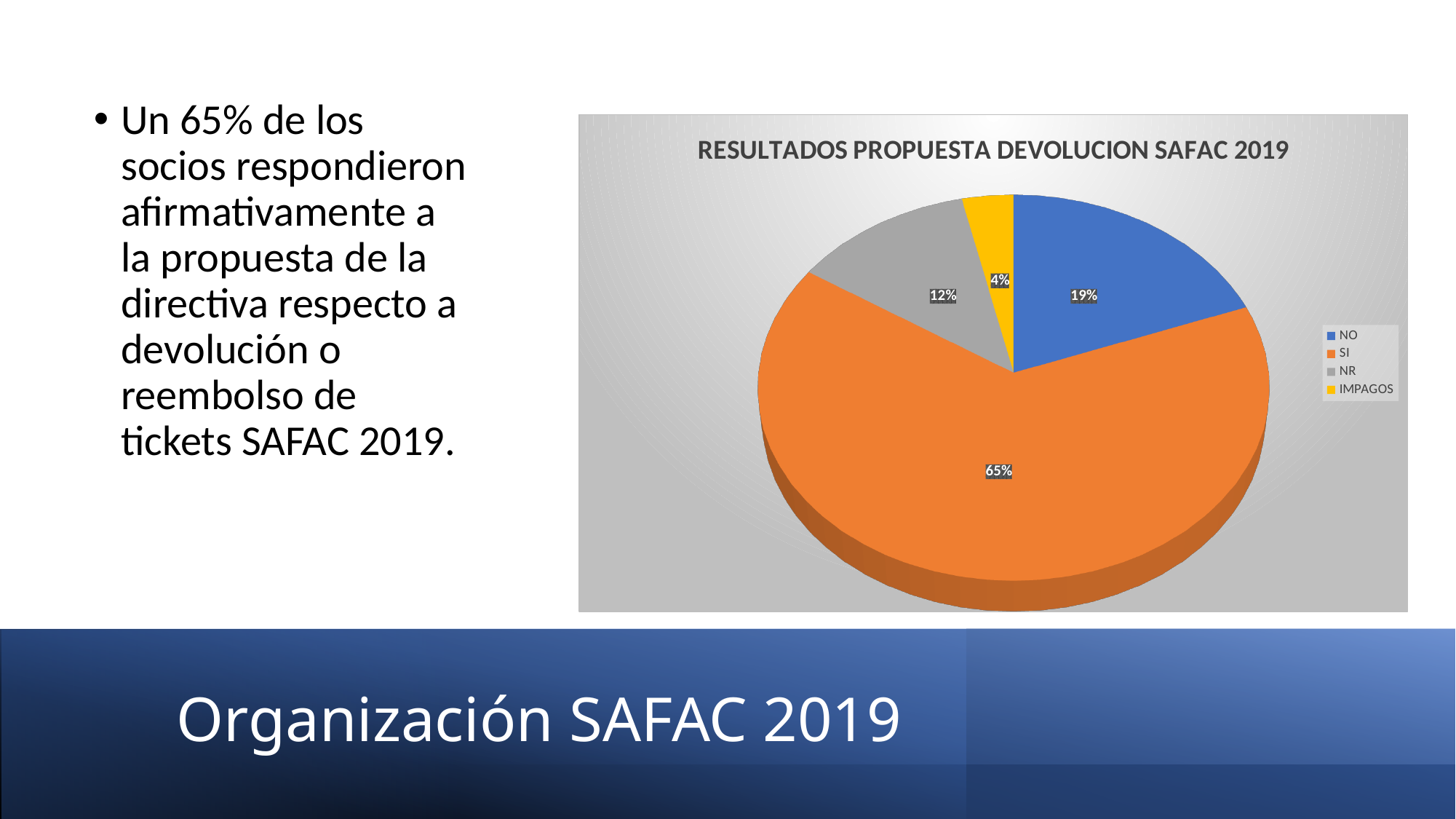
Which slice is larger, NO or NR? NO What is the difference in percentage points between the SI and NO slices? 46 What percentage of the pie does the NO slice represent? 19% What colour is the SI slice? Orange What is the title of the chart? RESULTADOS PROPUESTA DEVOLUCION SAFAC 2019 What type of chart is shown on the slide? Pie chart What percentage of the pie does the NR slice represent? 12% How many categories does the legend list? 4 What percentage of the pie does the IMPAGOS slice represent? 4% Which category has the smallest slice of the pie? IMPAGOS What percentage of the pie does the SI slice represent? 65% Which category has the largest slice of the pie? SI